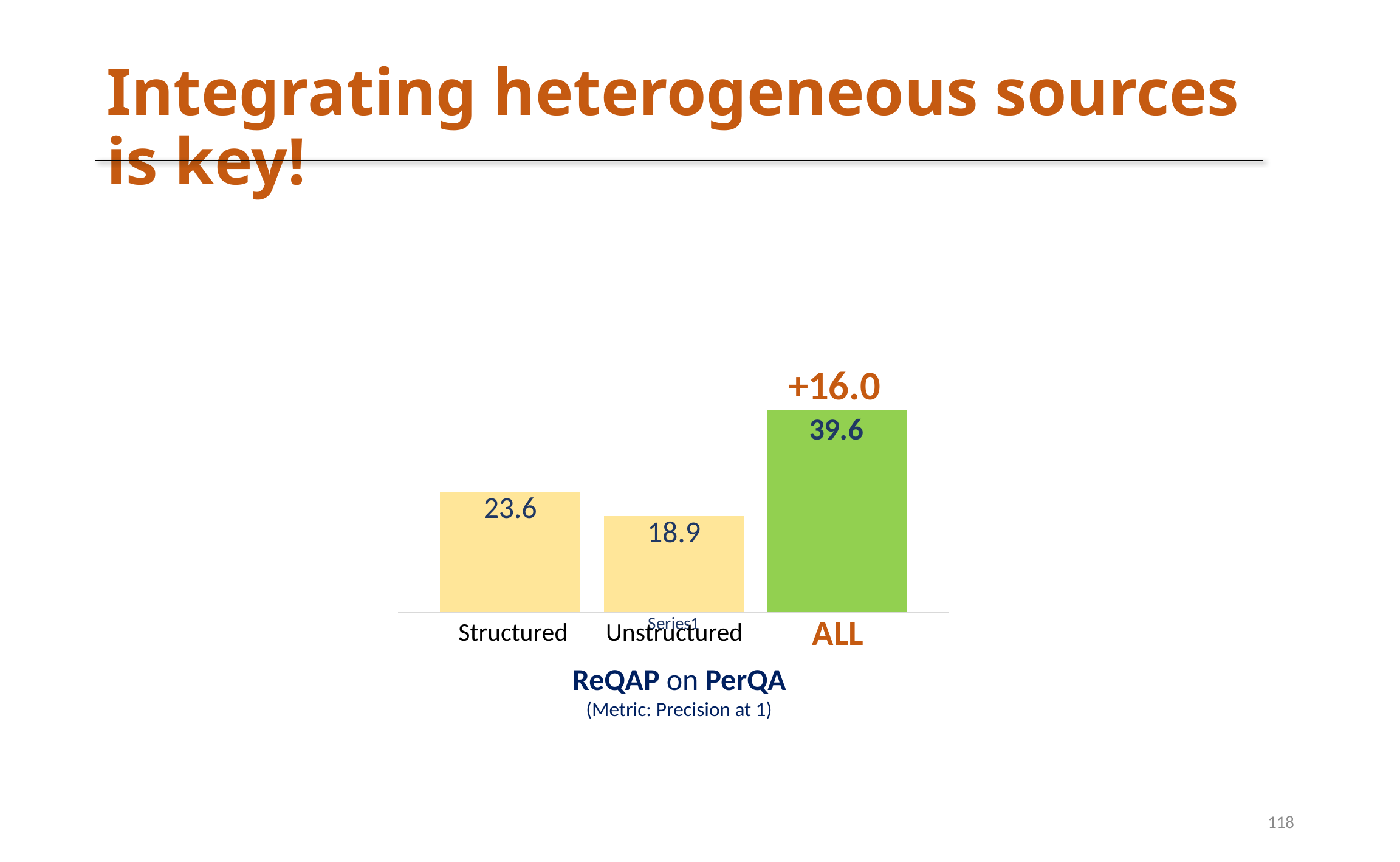
What kind of chart is shown on the slide? bar chart What is the value for Structured? 23.6 What is the difference between the values for ALL and Structured? 16.0 What is the difference between the values for Structured and Unstructured? 4.7 What is the value for ALL? 39.6 Which is larger, the value for Structured or the value for Unstructured? Structured What is the value for Unstructured? 18.9 What improvement is annotated above the ALL bar? +16.0 How many bars are shown in the chart? 3 What metric does the chart report, according to the text below it? Precision at 1 Which category has the lowest value? Unstructured Which category has the highest value? ALL